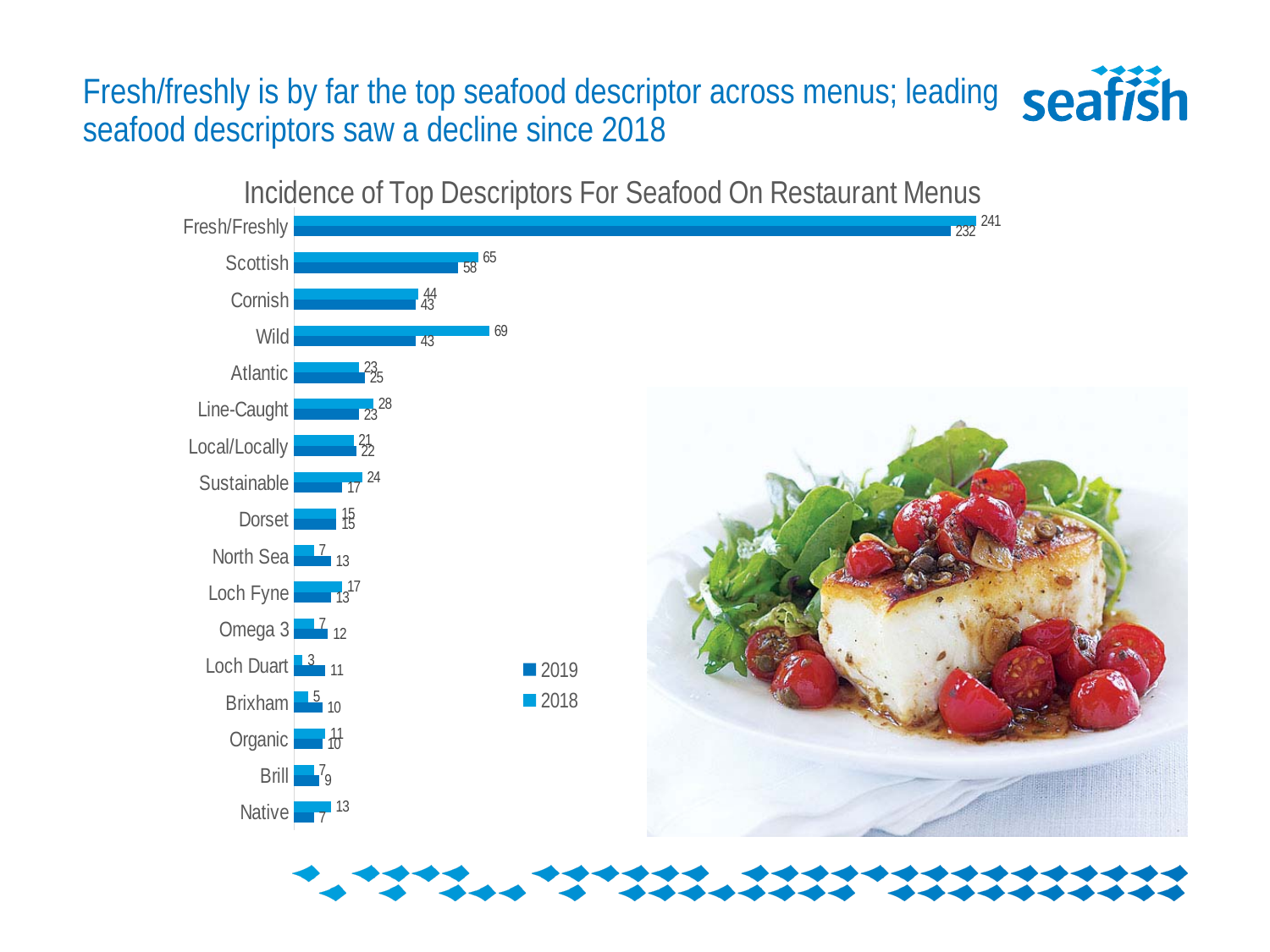
How many series does the chart's legend list? 2 What is the title of the chart? Incidence of Top Descriptors For Seafood On Restaurant Menus How many descriptor categories are plotted in the chart? 17 What value is shown for both years for Dorset? 15 Which descriptor has the larger maximum value, Scottish or Cornish? Scottish What kind of chart is shown on the slide? bar chart What is the difference between the two values shown for Wild? 26 Which descriptor has the smallest single value in the chart? Loch Duart What is the larger of the two values shown for Fresh/Freshly? 241 What is the difference between the two values shown for Scottish? 7 What is the larger of the two values shown for Wild? 69 Which descriptor has the highest incidence in the chart? Fresh/Freshly